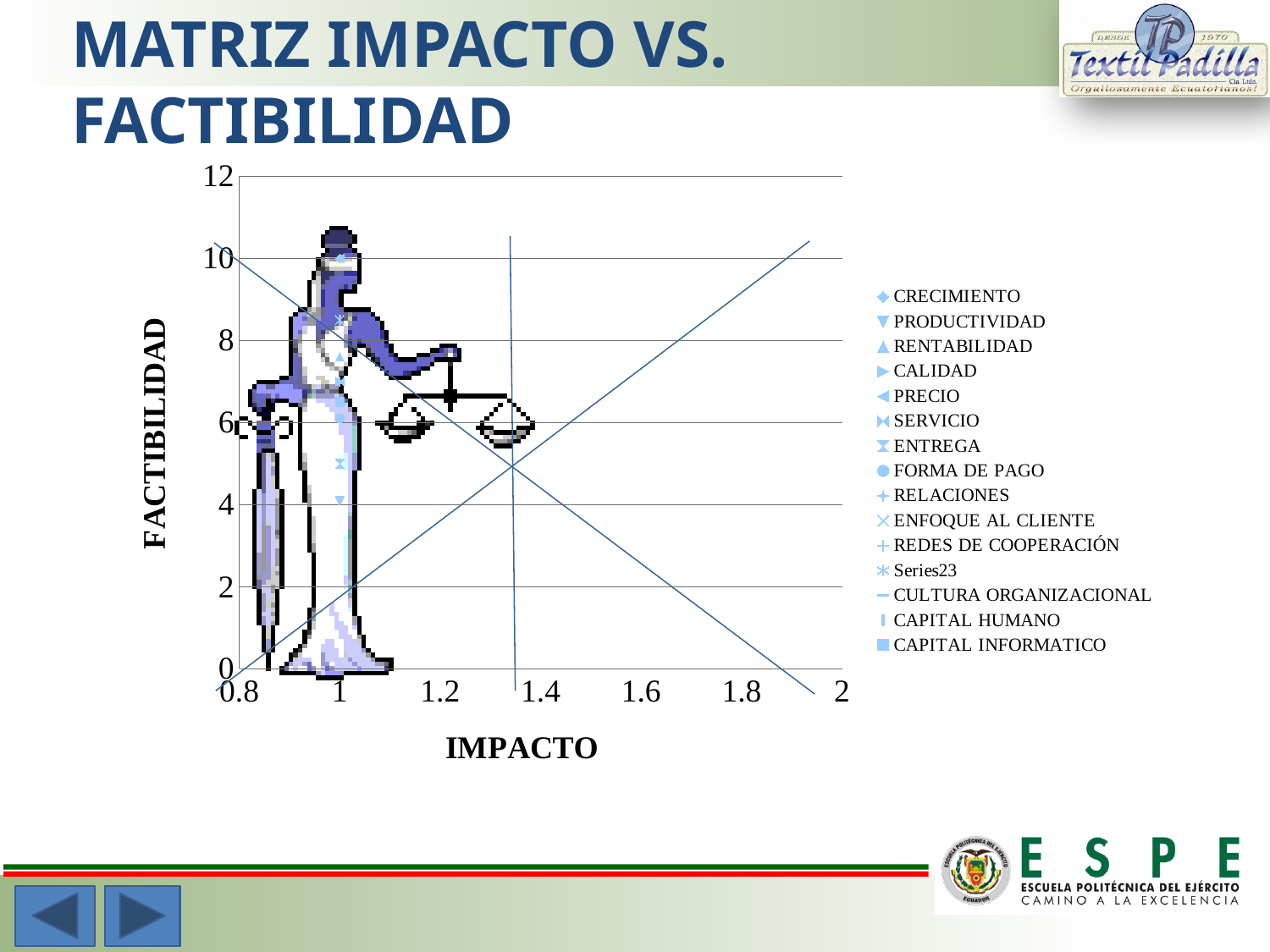
What is the last entry listed in the legend? CAPITAL INFORMATICO What kind of chart is shown on the slide? scatter chart Which legend entry appears immediately after RELACIONES? ENFOQUE AL CLIENTE What is the title of the vertical axis? FACTIBILIDAD Which legend entry has a generic, unnamed series label? Series23 How many series does the legend list? 15 What is the maximum value shown on the vertical axis? 12 What is the maximum value shown on the horizontal axis? 2 What is the minimum value shown on the horizontal axis? 0.8 What is the title of the horizontal axis? IMPACTO What is the first entry listed in the legend? CRECIMIENTO